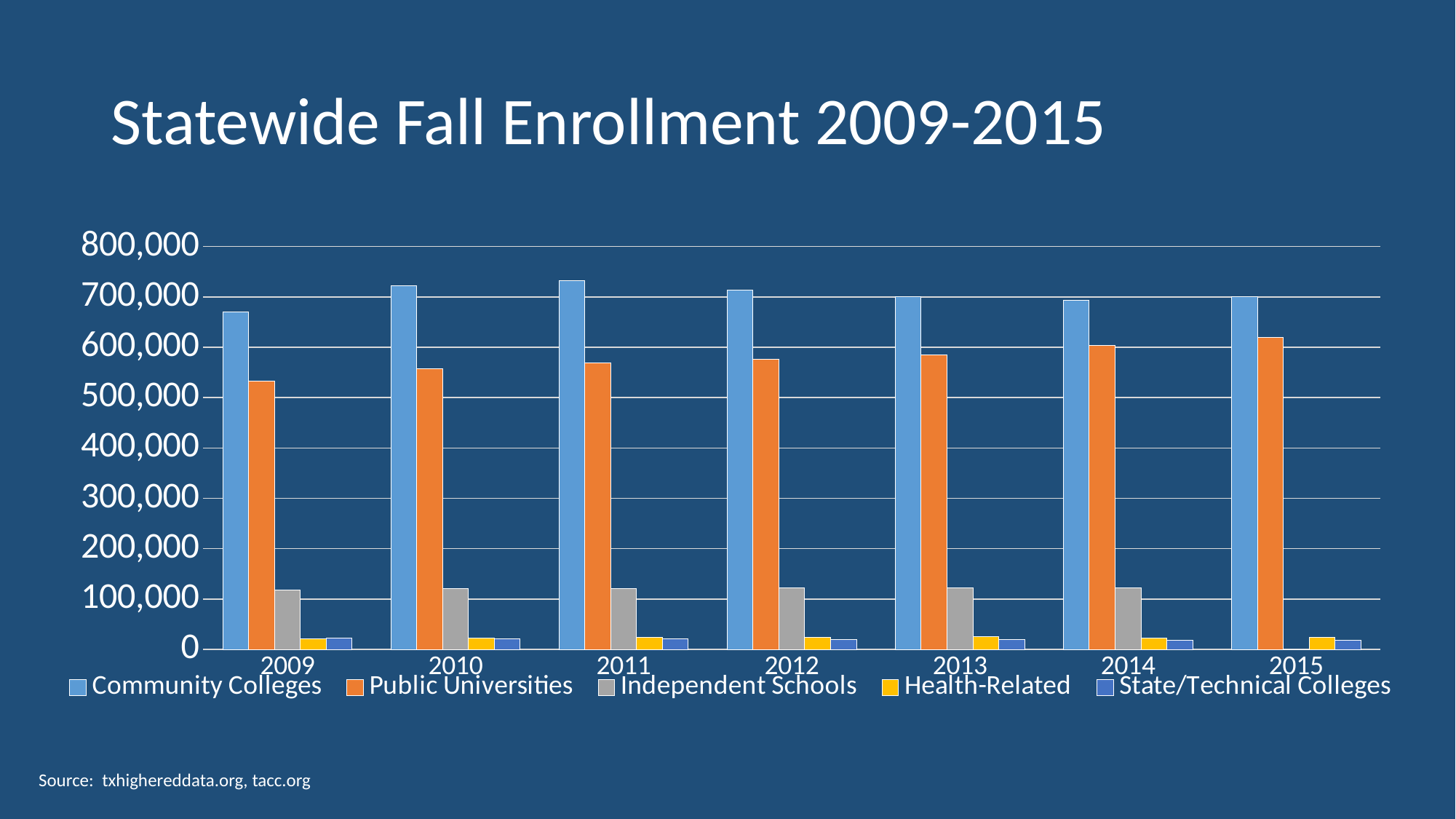
What is the title of the chart? Statewide Fall Enrollment 2009-2015 What kind of chart is shown on the slide? bar chart Is the value for Community Colleges in 2011 greater or less than 700,000? greater How many years are shown on the x axis? 7 Is the value for Public Universities in 2015 greater or less than 600,000? greater Do the Public Universities values rise or fall from 2009 to 2015? rise How many series does the legend list? 5 In 2009, which is larger: Community Colleges or Public Universities? Community Colleges Is the value for Public Universities in 2009 greater or less than 600,000? less In which year is Community Colleges enrollment highest? 2011 In which year is Community Colleges enrollment lowest? 2009